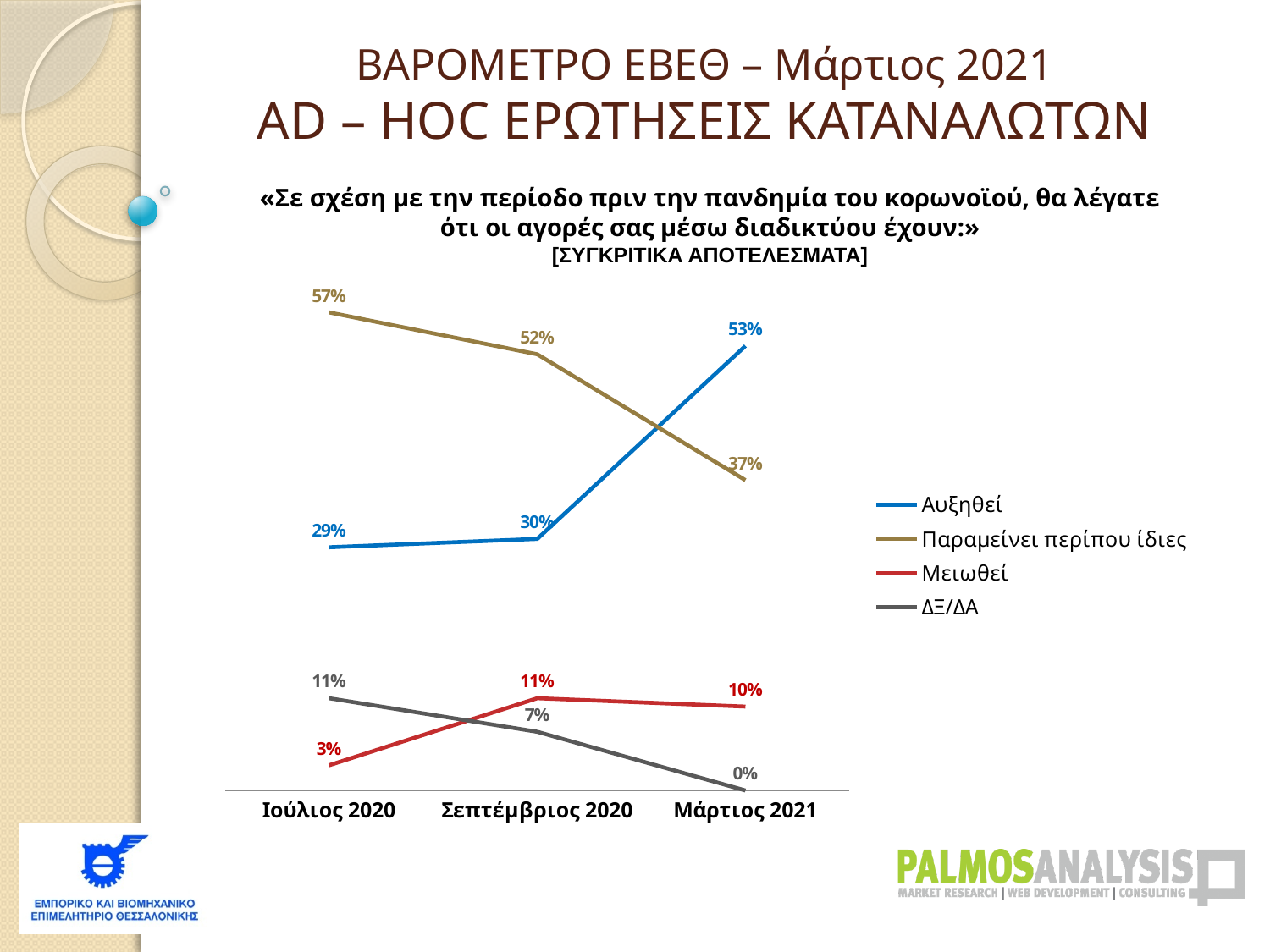
What is the value for Παραμείνει περίπου ίδιες in Ιούλιος 2020? 57% What is the difference between the Αυξηθεί values in Μάρτιος 2021 and Σεπτέμβριος 2020? 23% Which series is drawn in red? Μειωθεί What is the value for Μειωθεί in Σεπτέμβριος 2020? 11% Does the Παραμείνει περίπου ίδιες series rise or fall from Ιούλιος 2020 to Μάρτιος 2021? Fall What is the value for ΔΞ/ΔΑ in Μάρτιος 2021? 0% Which series has the lowest value in Μάρτιος 2021? ΔΞ/ΔΑ What is the value for Αυξηθεί in Μάρτιος 2021? 53% What type of chart is shown on the slide? Line chart Which series has the highest value in Ιούλιος 2020? Παραμείνει περίπου ίδιες How many time points are shown on the x axis? 3 How many series does the legend list? 4